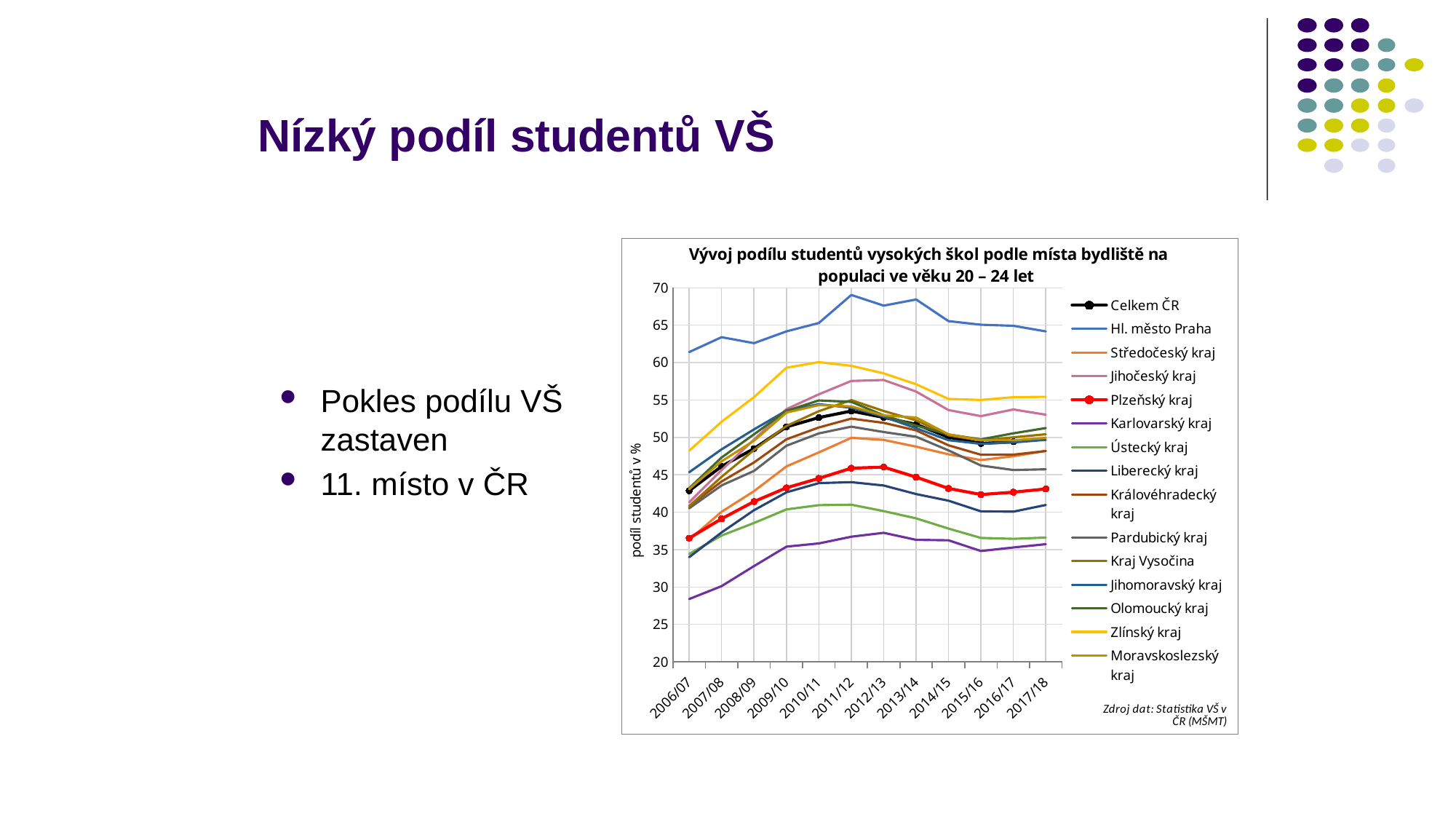
Which series has the highest values across the whole period? Hl. město Praha How many academic years are plotted along the x axis? 12 Which series has the lowest values across the whole period? Karlovarský kraj Does the value for Hl. město Praha rise or fall from 2011/12 to 2017/18? fall Is the value for Karlovarský kraj in 2006/07 greater or less than 30? less What kind of chart is shown on the slide? line chart Is the value for Celkem ČR in 2011/12 greater or less than 50? greater What is the label of the y axis? podíl studentů v % Is the value for Hl. město Praha in 2011/12 greater or less than 65? greater How many series does the legend list? 15